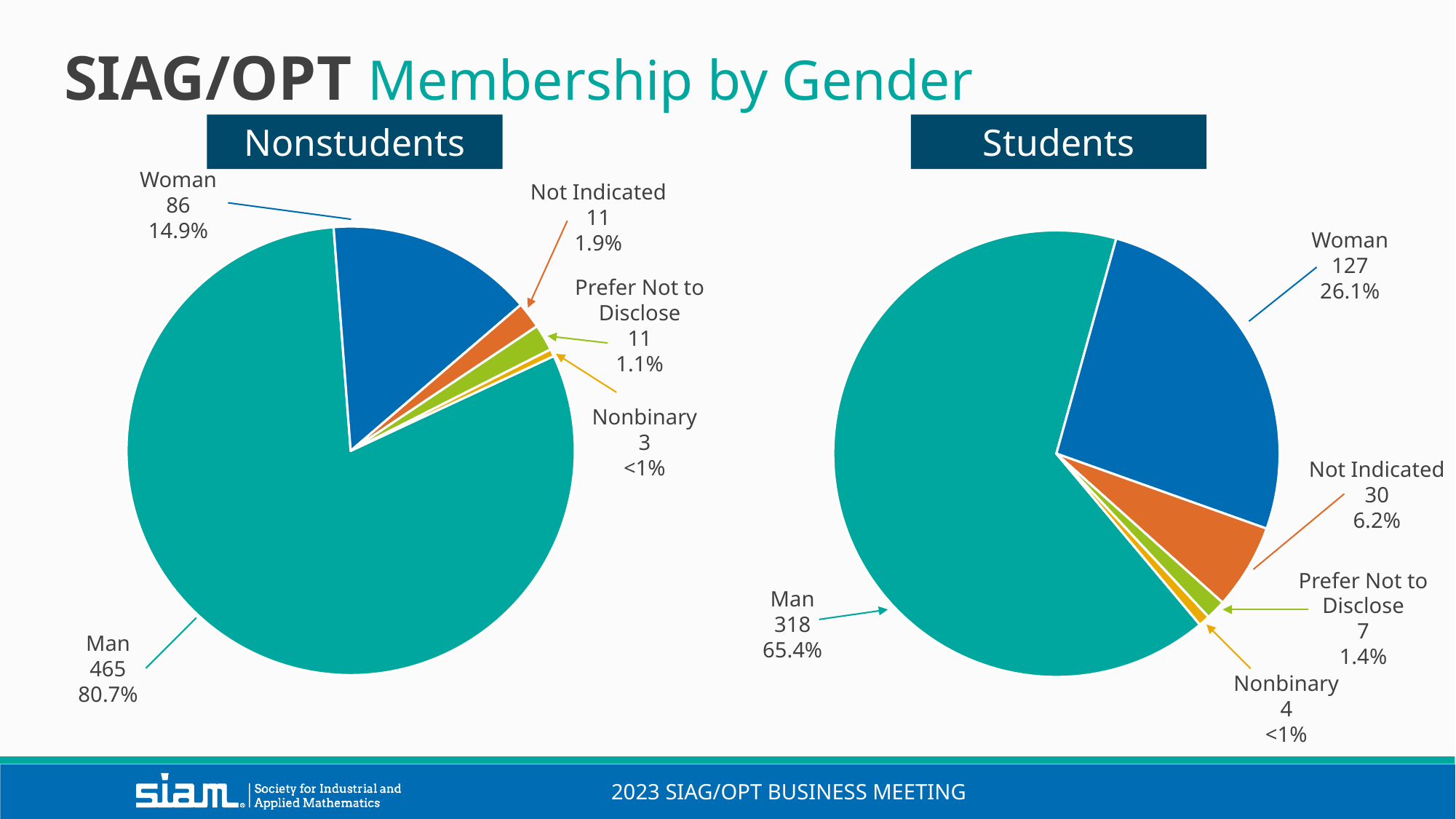
In the Nonstudents chart, what share of the pie is the Woman slice? 14.9% How many categories does the Students chart show? 5 In the Students chart, what share of the pie is the Man slice? 65.4% In the Nonstudents chart, how many members are in the Nonbinary category? 3 What kind of chart is the Nonstudents chart? pie chart In the Students chart, which is larger, the Not Indicated count or the Prefer Not to Disclose count? Not Indicated In the Nonstudents chart, which category has the smallest slice? Nonbinary In the Nonstudents chart, how many members are in the Man category? 465 In the Students chart, what is the difference between the Man count and the Woman count? 191 In the Students chart, how many members are in the Woman category? 127 In the Students chart, what share of the pie is the Not Indicated slice? 6.2% In the Students chart, which category has the largest slice? Man